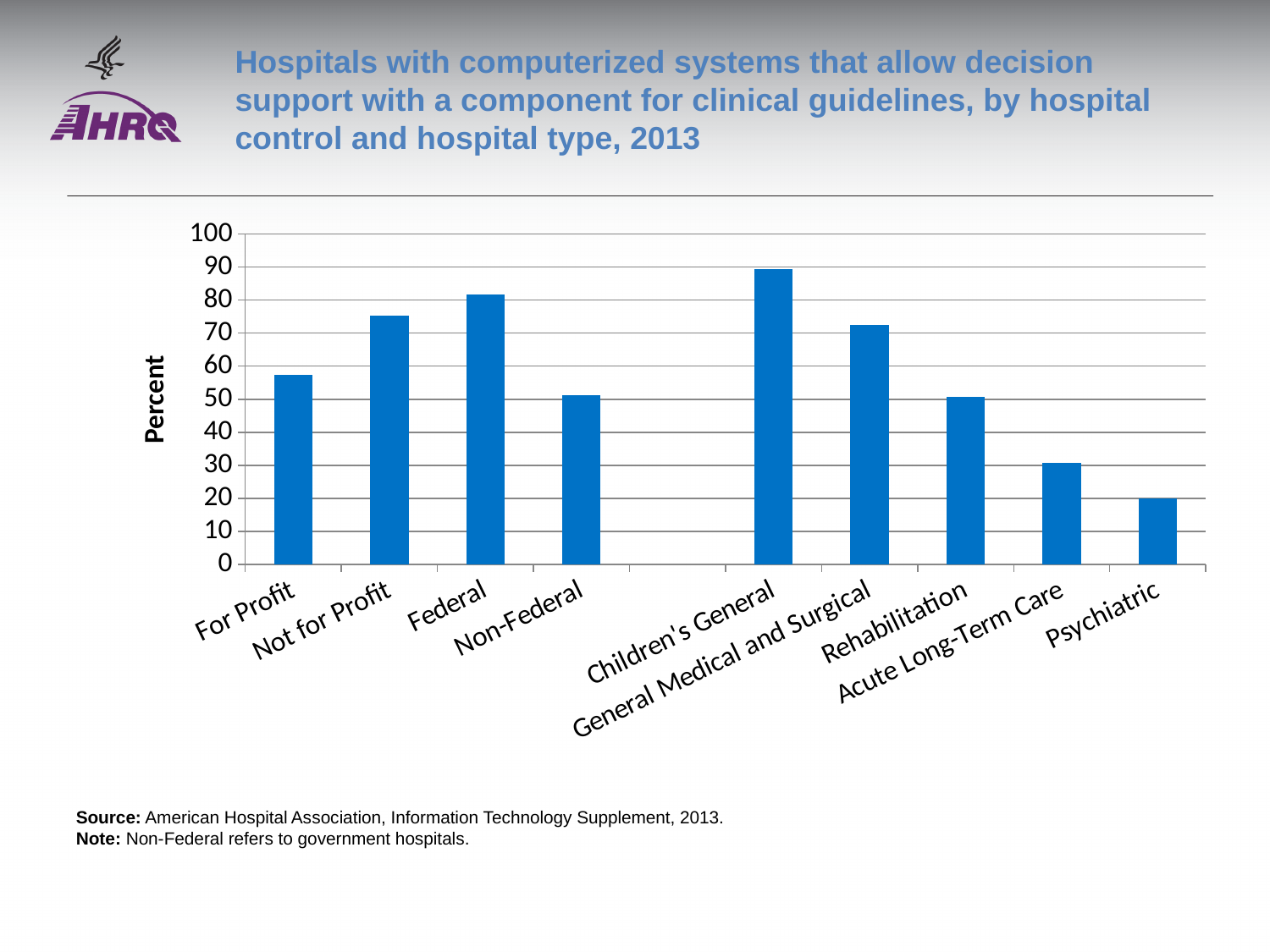
Is the value for Children's General greater or less than 80? greater Is the value for For Profit greater or less than 50? greater Is the value for Acute Long-Term Care greater or less than 40? less Which is larger, the value for Rehabilitation or the value for General Medical and Surgical? General Medical and Surgical What is the label on the vertical axis of the chart? Percent Which is larger, the value for Federal or the value for Not for Profit? Federal Which category has the lowest percentage? Psychiatric What kind of chart is shown on the slide? bar chart How many hospital categories are plotted on the chart? 9 Which category has the highest percentage? Children's General